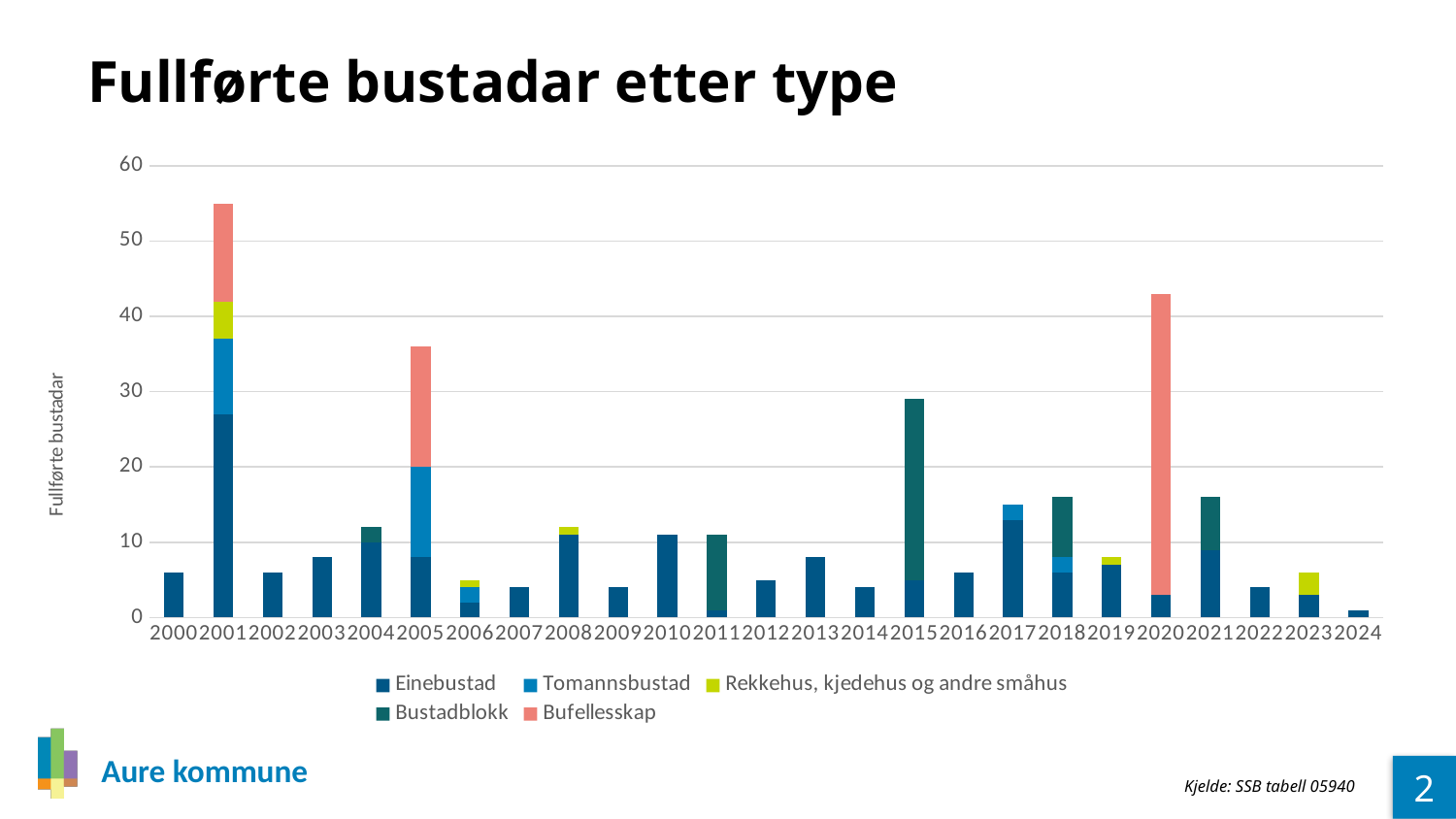
Which year has the larger total, 2001 or 2020? 2001 How many years are shown along the x axis? 25 Is the total for 2001 greater or less than 50? greater How many series does the legend list? 5 Is the total for 2024 greater or less than 10? less What kind of chart is shown on the slide? Stacked bar chart Which year has the lowest total of completed dwellings? 2024 Is the total for 2005 greater or less than 30? greater Which year has the highest total of completed dwellings? 2001 Which year has the larger total, 2005 or 2015? 2005 What is the title of the chart? Fullførte bustadar etter type